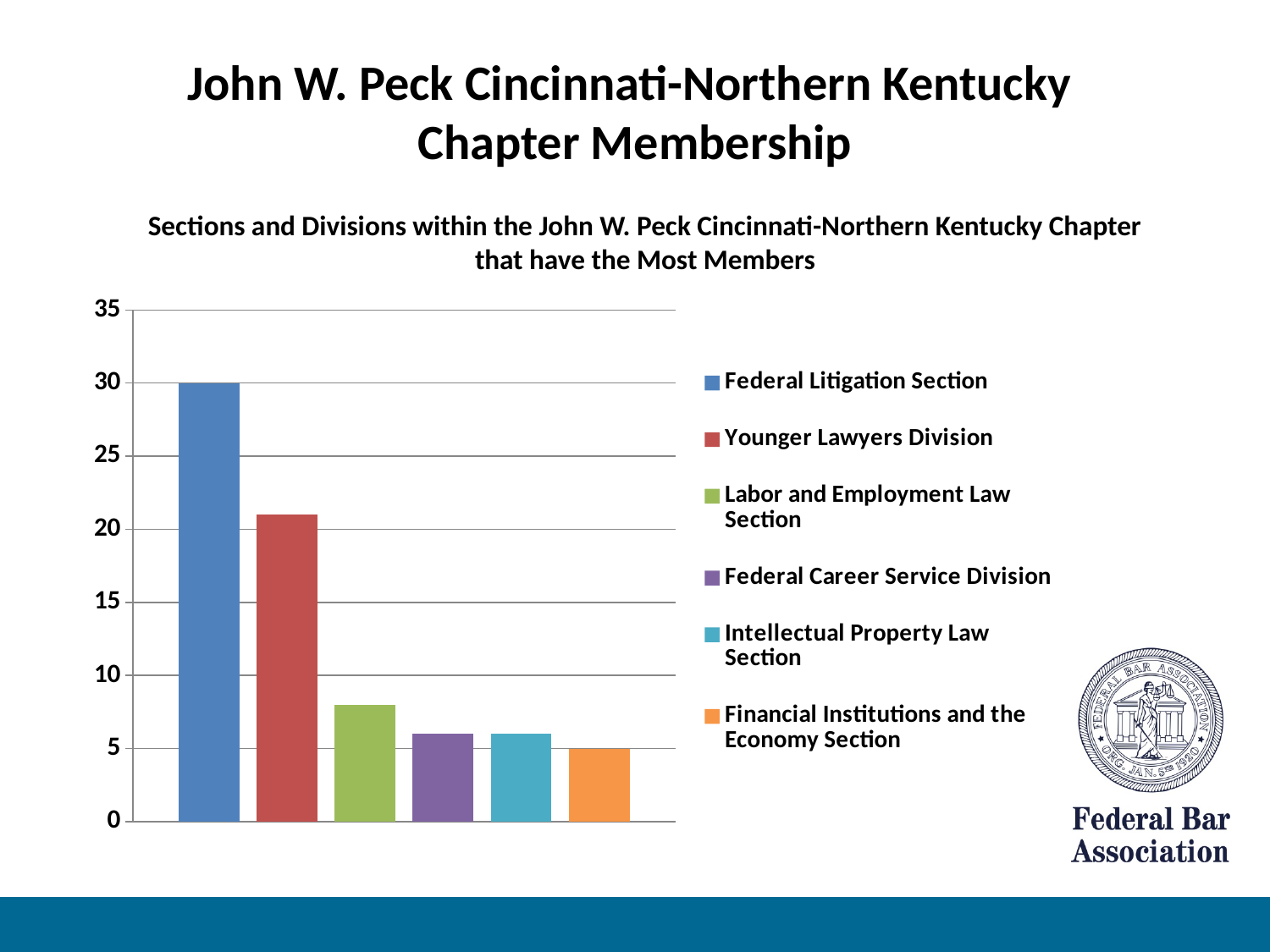
How many series does the chart legend list? 6 Is the value for the Labor and Employment Law Section greater or less than 10? less What is the value for the Federal Litigation Section? 30 Is the value for the Younger Lawyers Division greater or less than 20? greater Which section or division has the highest number of members in the chart? Federal Litigation Section Which is larger, the value for the Younger Lawyers Division or the value for the Labor and Employment Law Section? Younger Lawyers Division How many bars are plotted in the chart? 6 What type of chart is shown on the slide? Bar chart Do the bar values rise or fall from left to right across the chart? Fall What is the value for the Financial Institutions and the Economy Section? 5 Which section or division has the lowest number of members in the chart? Financial Institutions and the Economy Section What is the title of the chart? Sections and Divisions within the John W. Peck Cincinnati-Northern Kentucky Chapter that have the Most Members